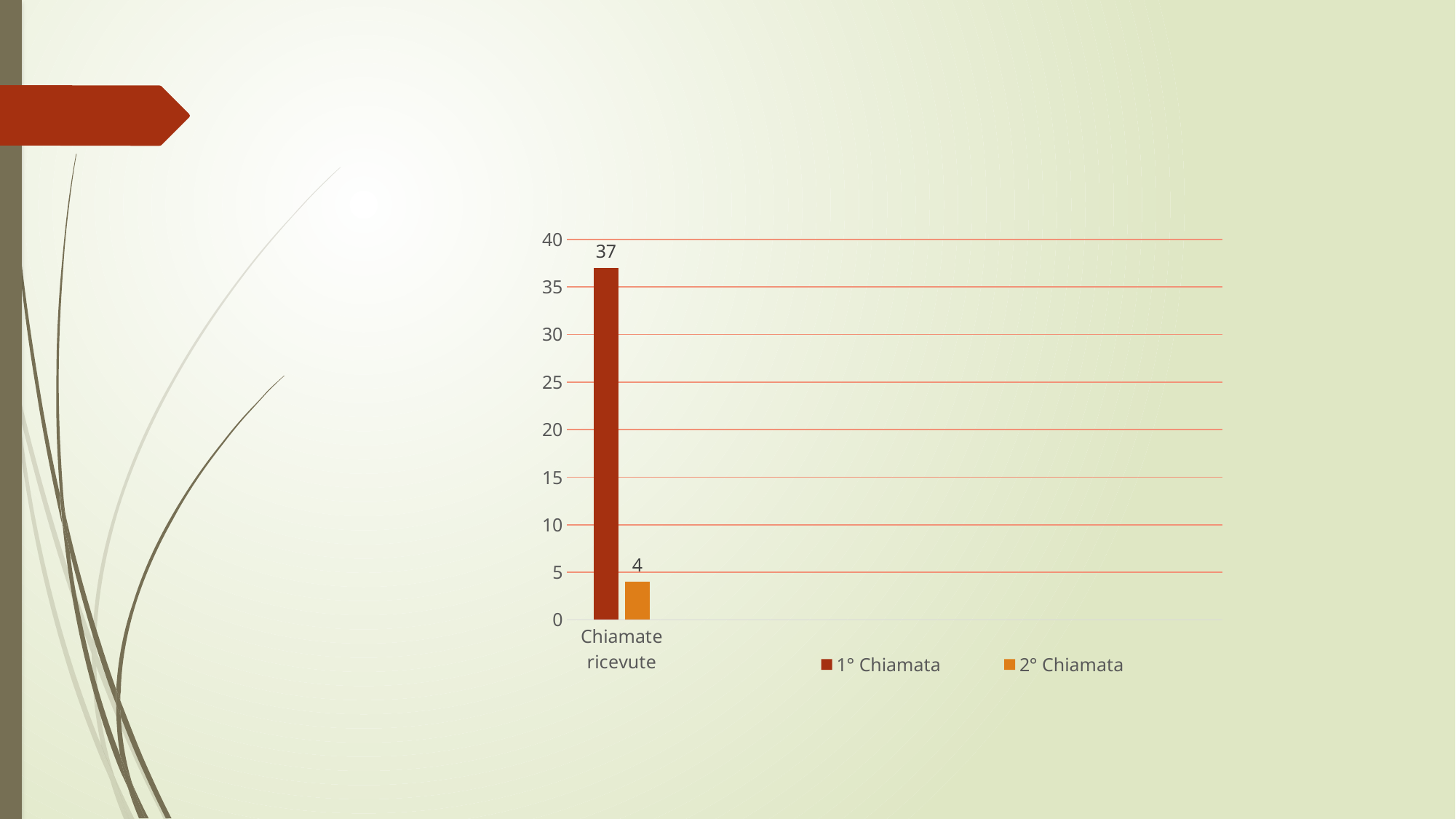
What is the value for 1° Chiamata in the Chiamate ricevute category? 37 What is the maximum value shown on the y axis? 40 How many categories are shown on the x axis? 1 What is the difference between the 1° Chiamata and 2° Chiamata values? 33 What is the value for 2° Chiamata in the Chiamate ricevute category? 4 Which series has the higher value for Chiamate ricevute, 1° Chiamata or 2° Chiamata? 1° Chiamata Is the value for 1° Chiamata greater or less than 35? greater How many series does the legend list? 2 What kind of chart is shown on the slide? bar chart What is the label of the category on the x axis? Chiamate ricevute Which series has the lowest value on the chart? 2° Chiamata Is the value for 2° Chiamata greater or less than 5? less